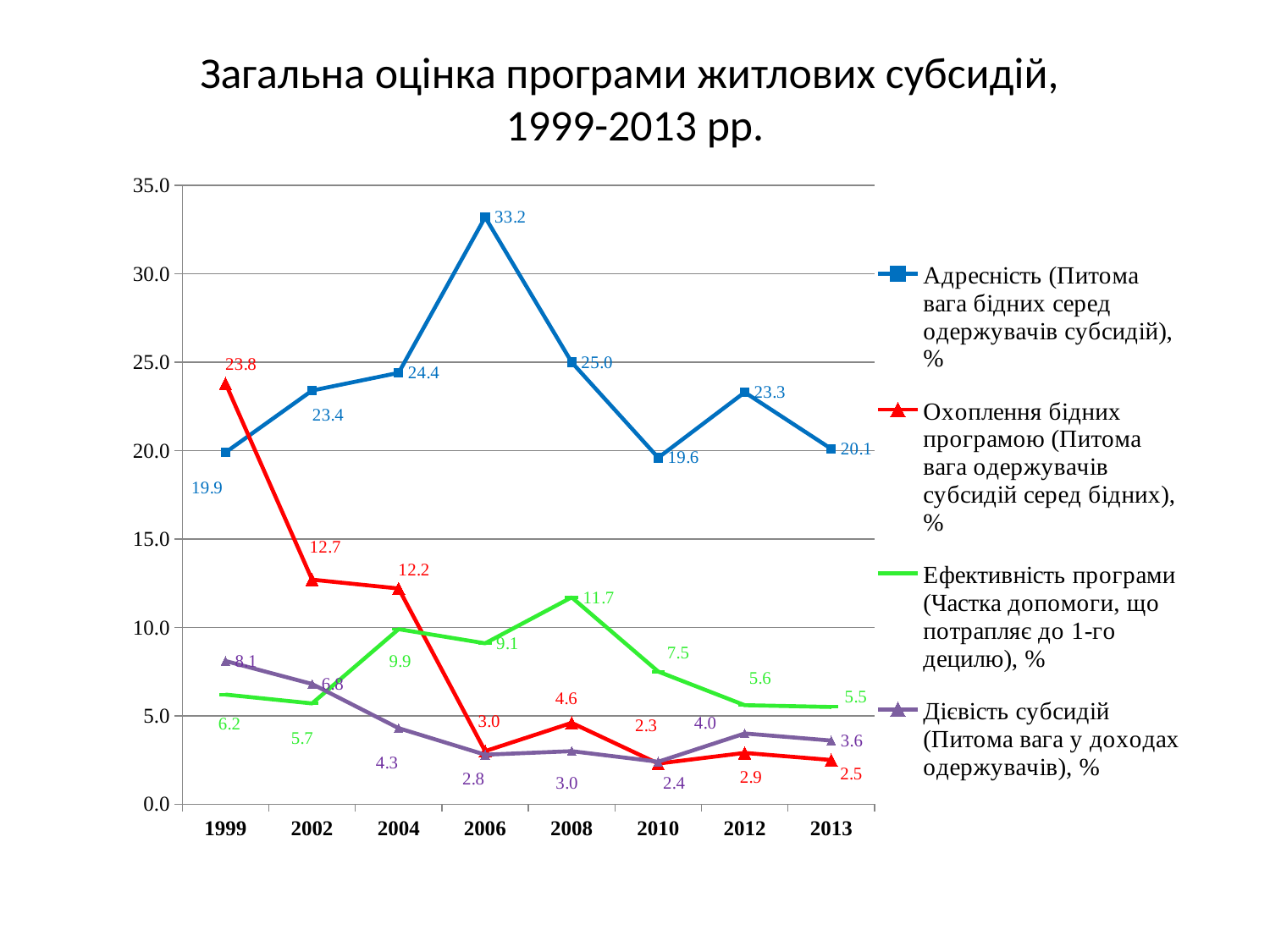
Which series has the larger value in 2013: Ефективність програми (green) or Дієвість субсидій (purple)? Ефективність програми (green) Does the Охоплення бідних програмою (red) series generally rise or fall from 1999 to 2013? fall How many years are shown on the x axis? 8 What is the value of Адресність (blue series) in 2006? 33.2 How many series does the legend list? 4 What is the value of Охоплення бідних програмою (red series) in 1999? 23.8 In which year does the Адресність (blue) series reach its highest value? 2006 In which year does the Охоплення бідних програмою (red) series have its lowest value? 2010 What is the difference between the Адресність value in 2006 and in 2010? 13.6 What is the title of the chart? Загальна оцінка програми житлових субсидій, 1999-2013 рр. What is the value of Ефективність програми (green series) in 2008? 11.7 What type of chart is shown on the slide? line chart